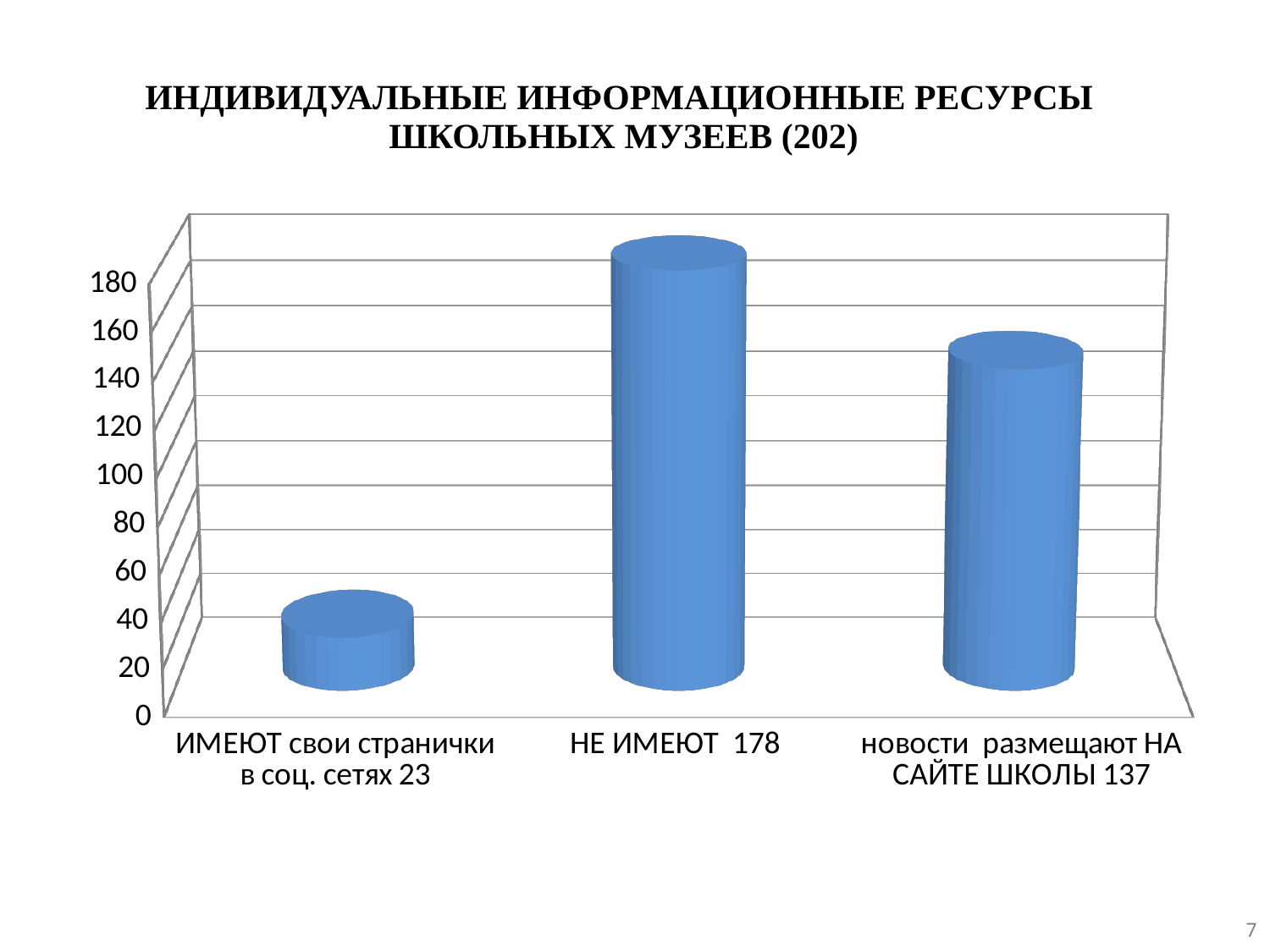
How many categories are shown in the chart? 3 What is the difference between the values for 'НЕ ИМЕЮТ' and 'новости размещают НА САЙТЕ ШКОЛЫ'? 41 Which category has the lowest value? ИМЕЮТ свои странички в соц. сетях What is the difference between the values for 'новости размещают НА САЙТЕ ШКОЛЫ' and 'ИМЕЮТ свои странички в соц. сетях'? 114 What value is shown for the category 'новости размещают НА САЙТЕ ШКОЛЫ'? 137 What value is shown for the category 'ИМЕЮТ свои странички в соц. сетях'? 23 Which is larger: the value for 'НЕ ИМЕЮТ' or the value for 'новости размещают НА САЙТЕ ШКОЛЫ'? НЕ ИМЕЮТ What number appears in parentheses in the slide title? 202 Which category has the highest value? НЕ ИМЕЮТ Is the value for 'ИМЕЮТ свои странички в соц. сетях' greater or less than 40? less What value is shown for the category 'НЕ ИМЕЮТ'? 178 What kind of chart is shown on the slide? bar chart